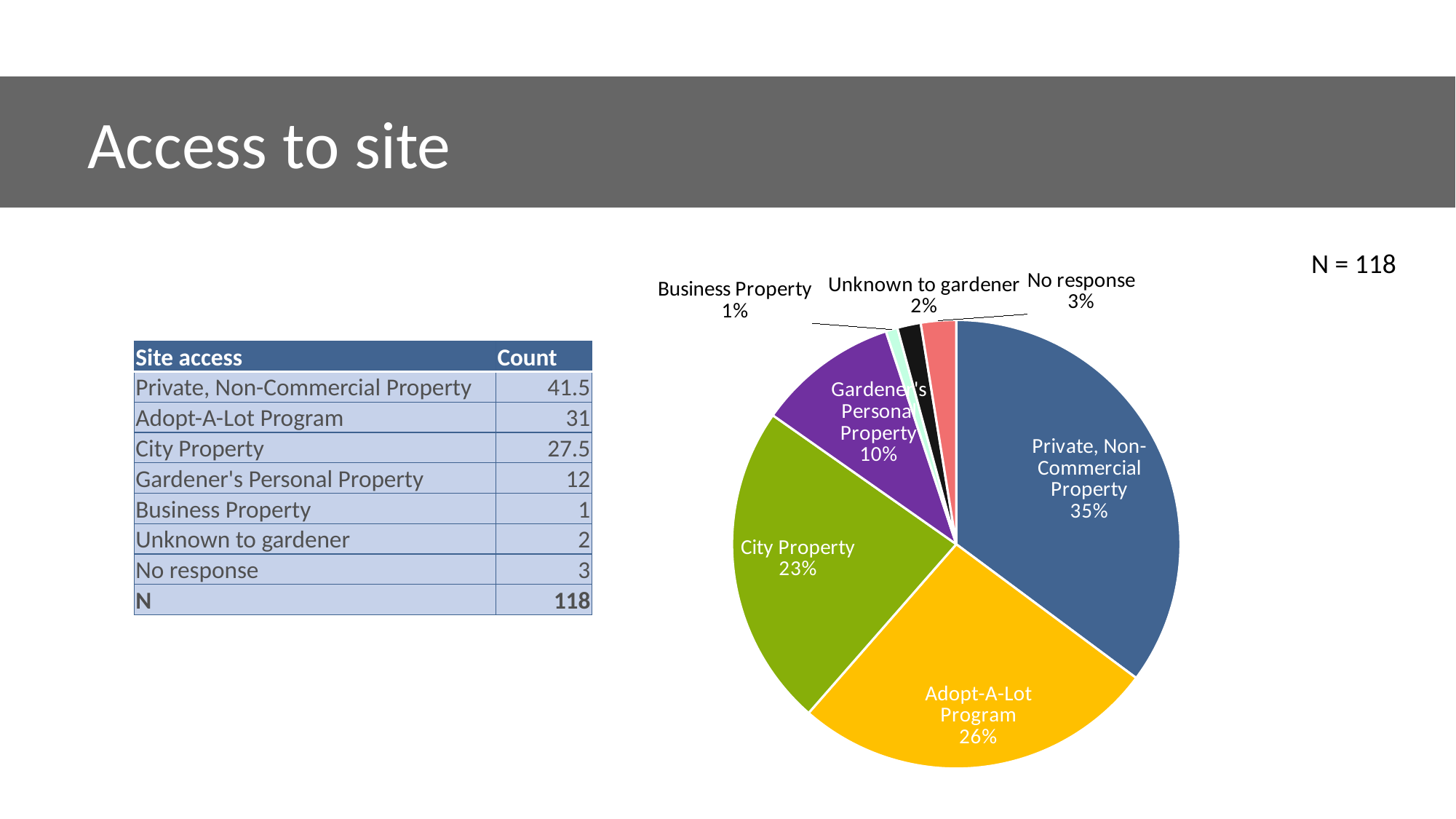
What percentage of the pie chart is Private, Non-Commercial Property? 35% Which category has the smallest slice of the pie chart? Business Property What percentage of the pie chart is Adopt-A-Lot Program? 26% What is the difference in percentage points between Adopt-A-Lot Program and City Property in the pie chart? 3 Which category has the largest slice of the pie chart? Private, Non-Commercial Property What percentage of the pie chart is City Property? 23% How many categories are shown in the pie chart? 7 What is the N value shown next to the pie chart? 118 What percentage of the pie chart is No response? 3% What percentage of the pie chart is Gardener's Personal Property? 10% What type of chart is shown on the slide? pie chart Which is larger in the pie chart, City Property or Gardener's Personal Property? City Property